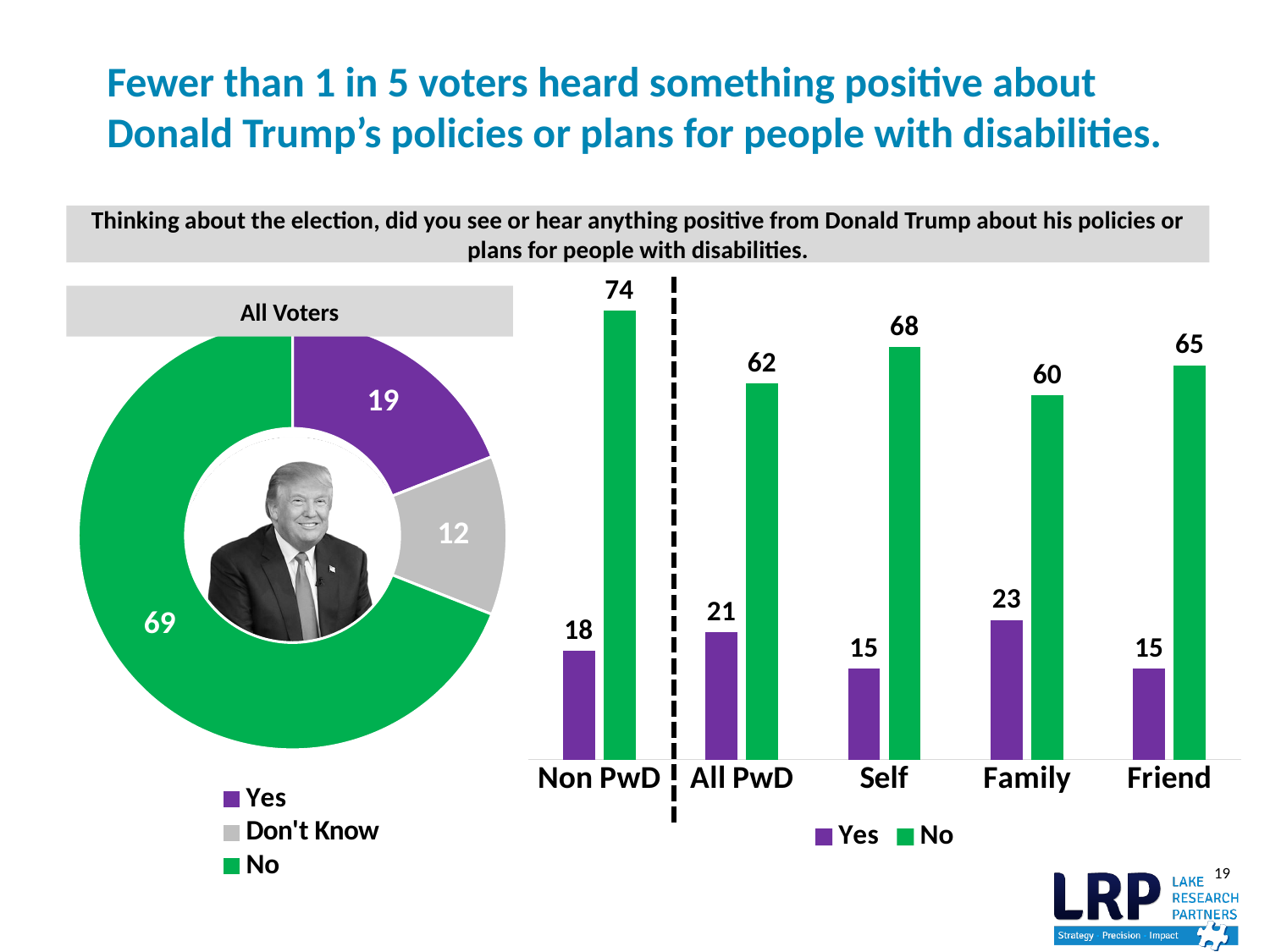
In the All Voters donut chart, how many categories does the legend list? 3 In the bar chart on the right, which group has the lowest No value? Family In the All Voters donut chart, what value is shown for Yes? 19 In the bar chart on the right, how many groups are shown on the x axis? 5 In the All Voters donut chart, which response has the largest share? No In the bar chart on the right, is the Yes value for All PwD larger or smaller than the Yes value for Non PwD? larger In the All Voters donut chart, what value is shown for Don't Know? 12 In the bar chart on the right, what is the Yes value for Family? 23 What kind of chart is the All Voters chart on the left? Donut (pie) chart In the bar chart on the right, which group has the highest Yes value? Family In the bar chart on the right, what is the No value for Non PwD? 74 In the bar chart on the right, what is the difference between the No and Yes values for Self? 53